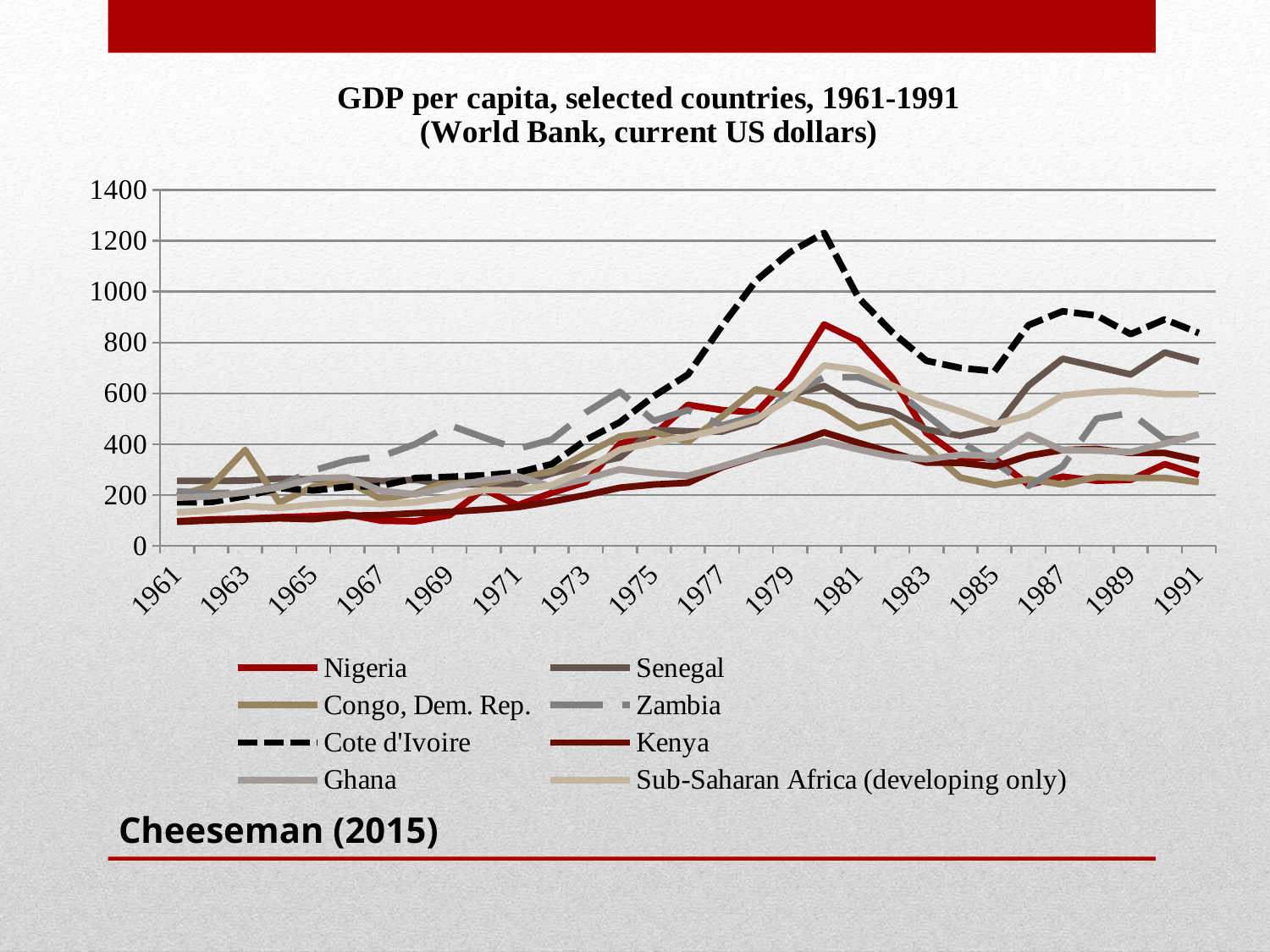
Which series is drawn as a black dashed line? Cote d'Ivoire What is the title of the chart? GDP per capita, selected countries, 1961-1991 (World Bank, current US dollars) Is the value for Cote d'Ivoire in 1980 greater or less than 1000? greater Does the value for Cote d'Ivoire rise or fall between 1961 and 1980? rise Is the value for Senegal in 1991 greater or less than 600? greater How many year labels are shown on the x axis? 16 What kind of chart is shown on the slide? line chart Is the value for Nigeria in 1980 greater or less than 800? greater Which is larger in 1991, the value for Cote d'Ivoire or the value for Kenya? Cote d'Ivoire How many series does the legend list? 8 Which country has the highest GDP per capita in 1980? Cote d'Ivoire